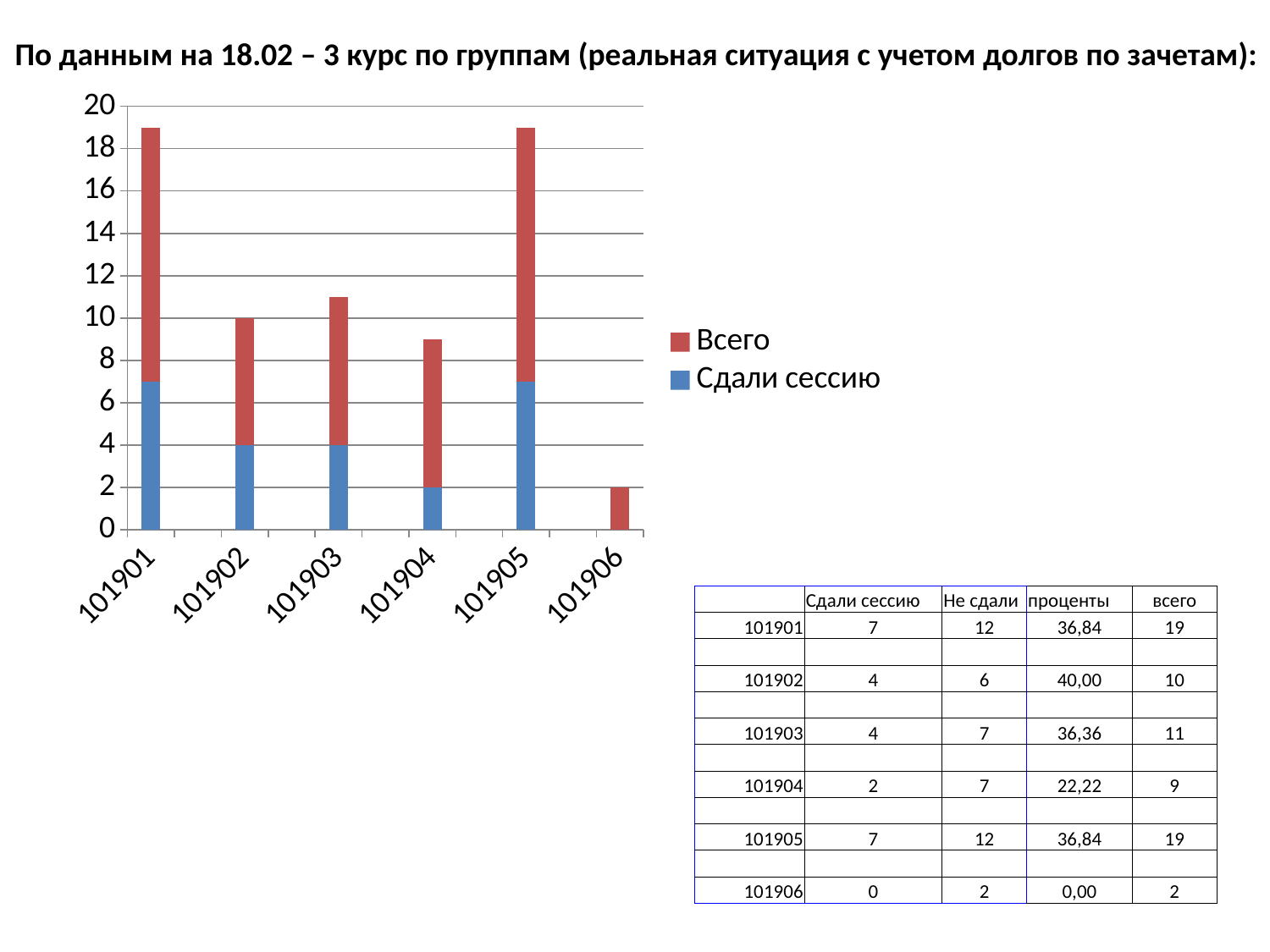
What is the value of "Сдали сессию" for group 101904? 2 What is the total height of the stacked bar for group 101903? 11 What type of chart is shown on the slide? bar chart Which group has the larger "Сдали сессию" value, 101902 or 101904? 101902 What is the value of "Сдали сессию" for group 101901? 7 Which group has the lowest value for "Сдали сессию"? 101906 Which group has the shortest stacked bar overall? 101906 How many groups (categories) are shown on the x axis of the chart? 6 Which series is shown in blue in the chart legend? Сдали сессию What is the difference between the "Сдали сессию" values for 101901 and 101903? 3 How many series does the chart legend list? 2 Is the total height of the stacked bar for 101905 greater or less than 18? greater